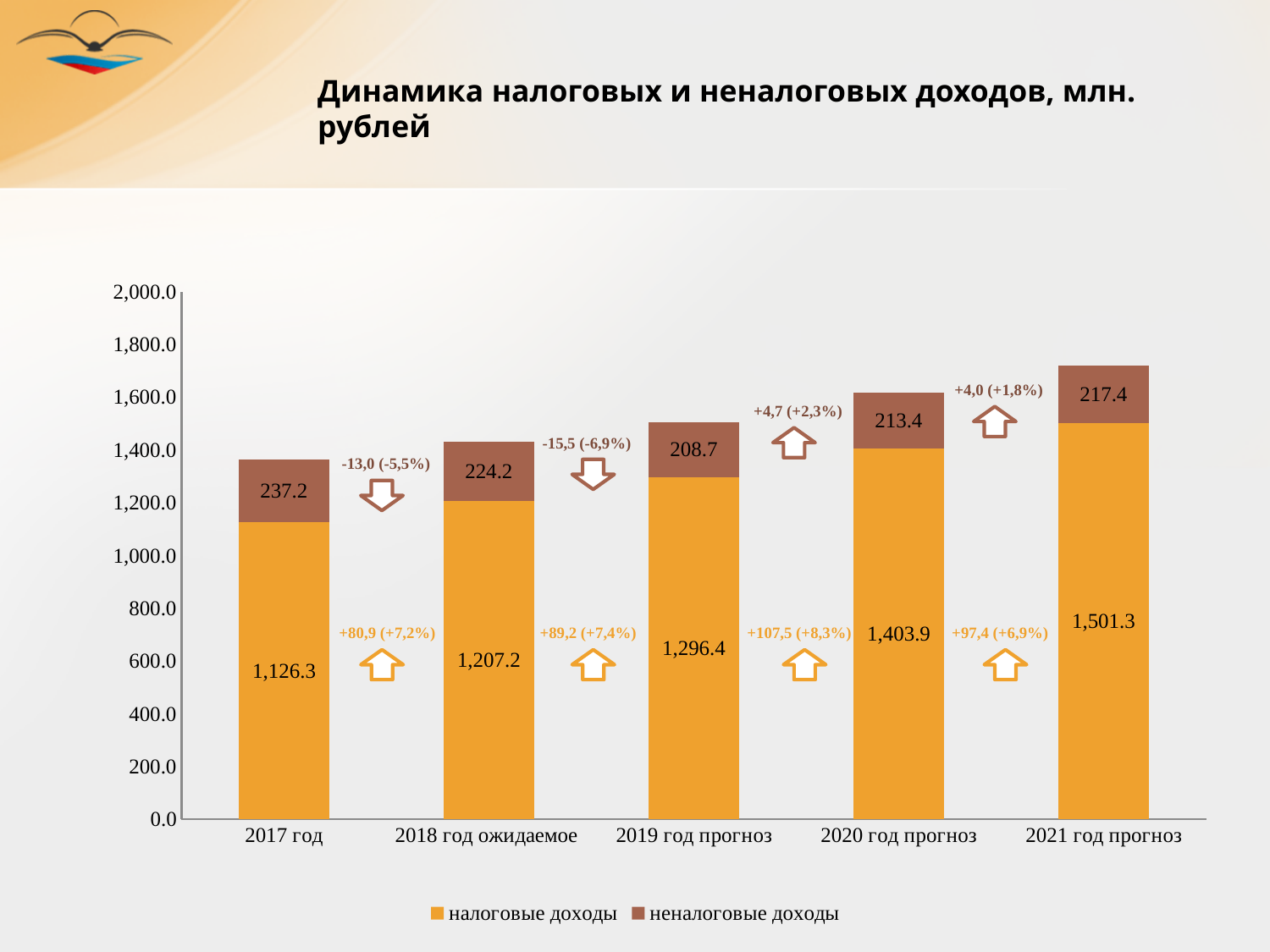
What is the difference in налоговые доходы between 2020 год прогноз and 2019 год прогноз? 107.5 What is the value of налоговые доходы for 2017 год? 1,126.3 Which year has the highest value of неналоговые доходы? 2017 год How many years (categories) are shown on the x axis? 5 How many series does the legend list? 2 Which is larger: неналоговые доходы in 2018 год ожидаемое or in 2021 год прогноз? 2018 год ожидаемое Which year has the lowest value of налоговые доходы? 2017 год What kind of chart is shown on the slide? Stacked bar chart Do the values of налоговые доходы rise or fall from 2017 год to 2021 год прогноз? Rise What is the total of the stacked bar for 2017 год? 1,363.5 What is the value of налоговые доходы for 2021 год прогноз? 1,501.3 What is the value of неналоговые доходы for 2019 год прогноз? 208.7